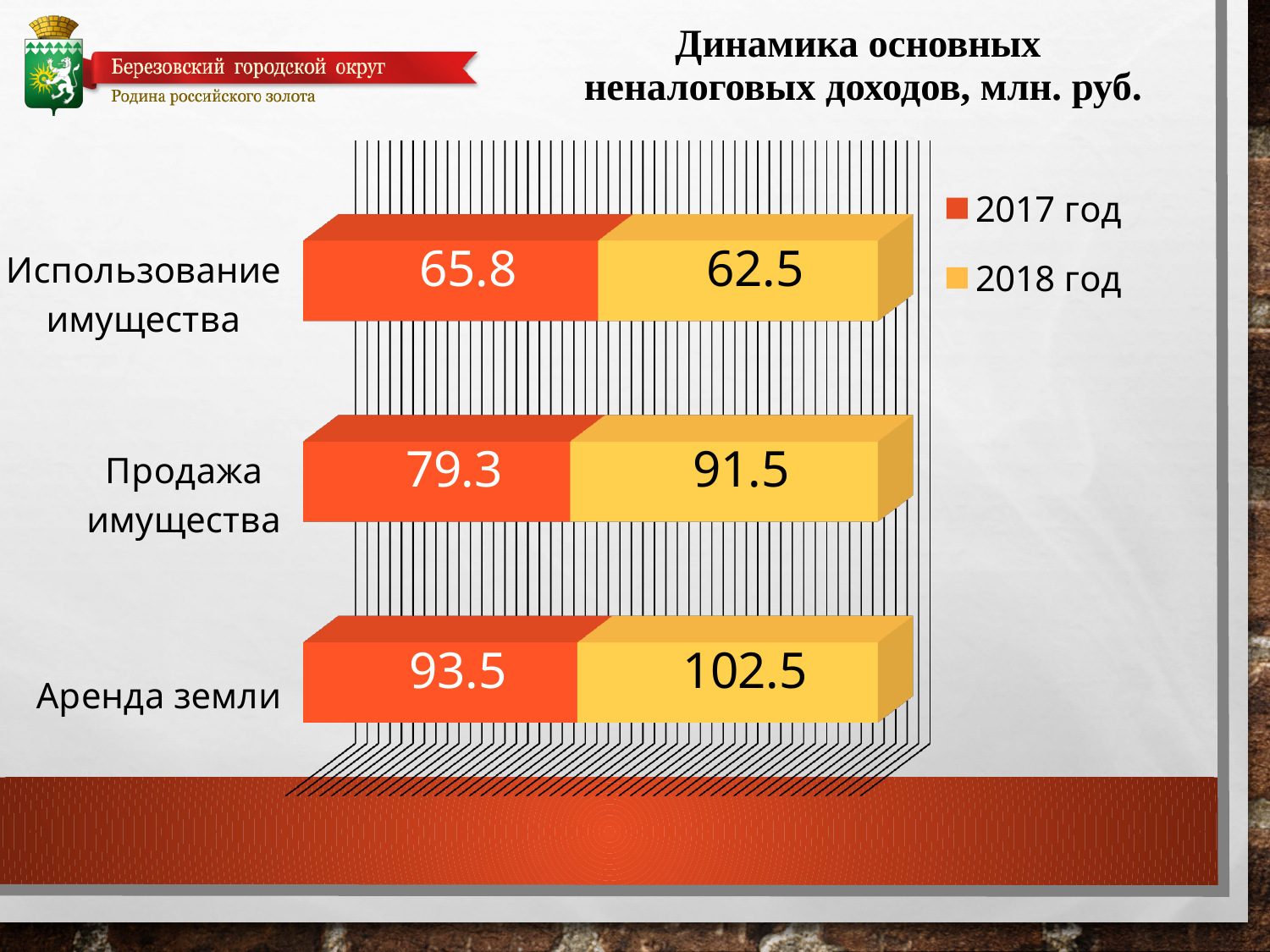
For Использование имущества, which is larger: the 2017 год value or the 2018 год value? 2017 год What is the difference between the 2018 год and 2017 год values for Аренда земли? 9 What type of chart is shown on the slide? Bar chart What is the value for 2018 год for Продажа имущества? 91.5 Which category has the highest value for 2018 год? Аренда земли What is the value for 2017 год for Продажа имущества? 79.3 What is the difference between the 2018 год and 2017 год values for Продажа имущества? 12.2 What is the value for 2017 год for Использование имущества? 65.8 How many series does the legend list? 2 Which category has the lowest value for 2017 год? Использование имущества How many categories are shown in the chart? 3 What is the value for 2018 год for Аренда земли? 102.5